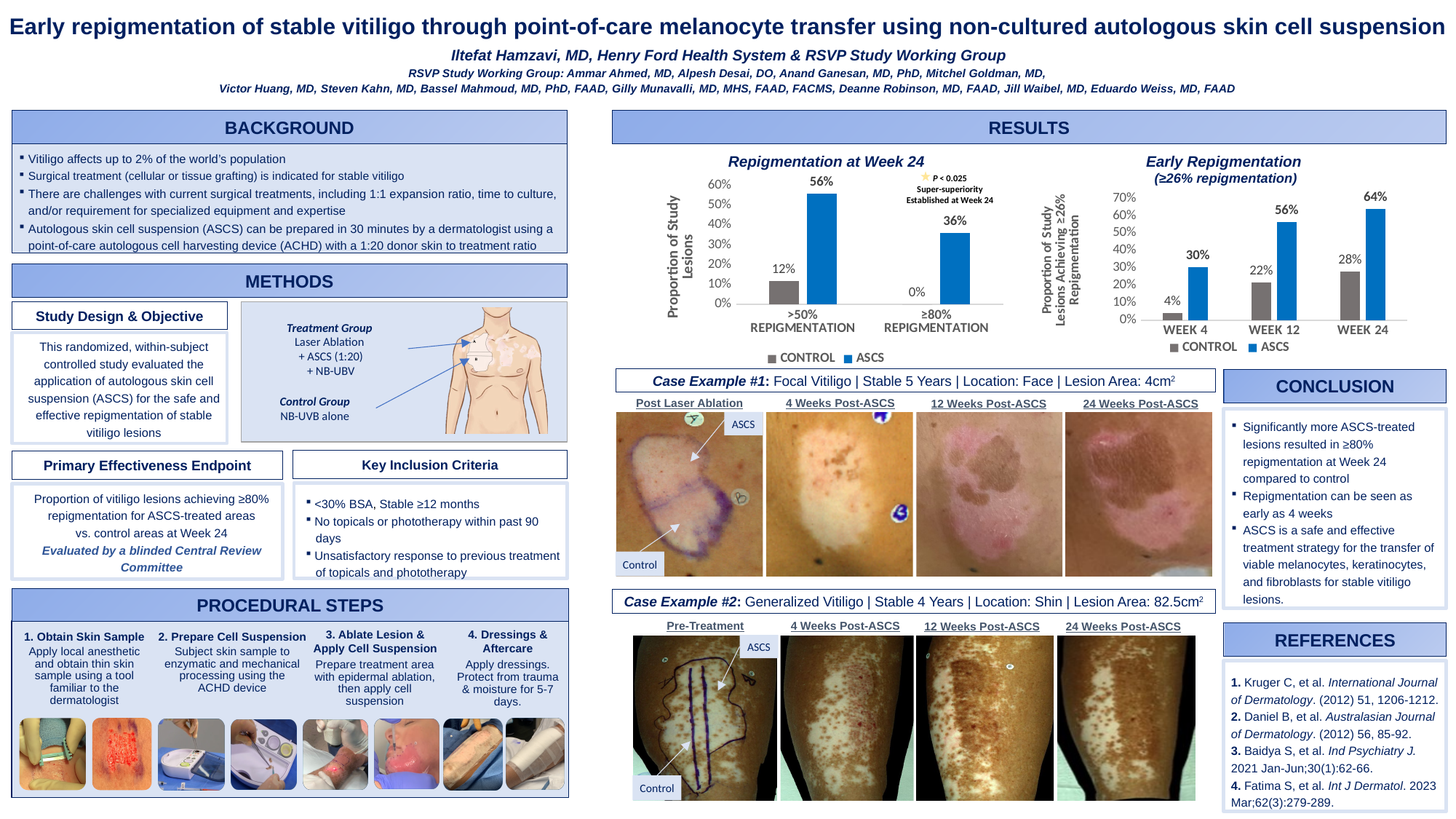
In the 'Repigmentation at Week 24' chart, what is the difference between the ASCS and Control values for >50% repigmentation? 44% What kind of chart is the 'Repigmentation at Week 24' chart? Bar chart In the 'Early Repigmentation' chart, what is the ASCS value at Week 12? 56% In the 'Early Repigmentation' chart, what is the difference between the ASCS and Control values at Week 24? 36% In the 'Early Repigmentation' chart, at which week is the ASCS value highest? Week 24 In the 'Repigmentation at Week 24' chart, what is the ASCS value for >50% repigmentation? 56% In the 'Early Repigmentation' chart, how many time points are shown on the x axis? 3 In the 'Early Repigmentation' chart, at which week is the Control value lowest? Week 4 In the 'Early Repigmentation' chart, do the ASCS values rise or fall from Week 4 to Week 24? Rise In the 'Early Repigmentation' chart, what is the Control value at Week 4? 4% In the 'Repigmentation at Week 24' chart, how many series does the legend list? 2 In the 'Repigmentation at Week 24' chart, what is the Control value for ≥80% repigmentation? 0%